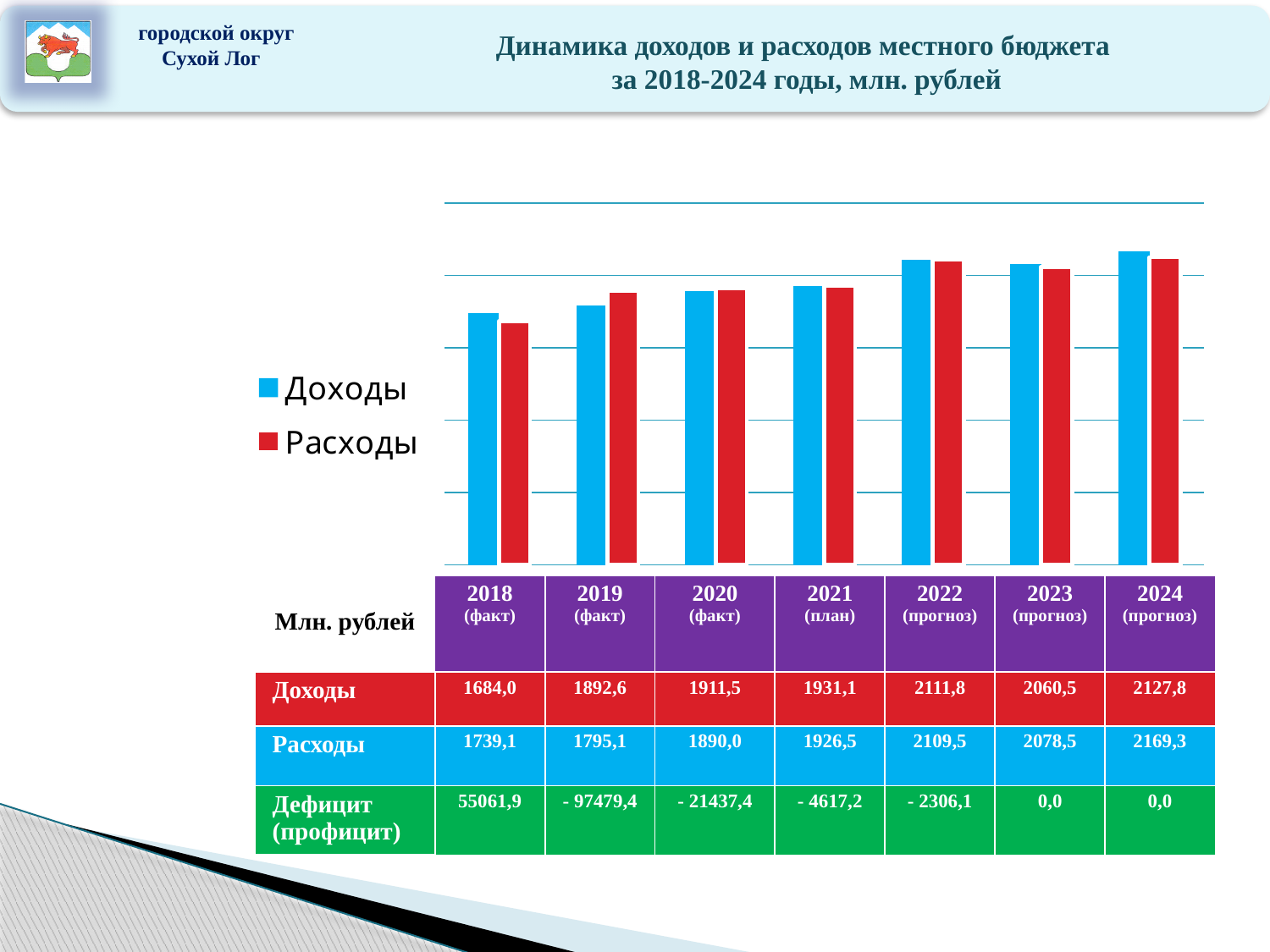
How many years are shown on the x axis of the chart? 7 Do the Доходы values rise or fall from 2018 to 2021? Rise In which year is Расходы the lowest? 2018 What is the value of Доходы for 2020 (факт)? 1911,5 What kind of chart is shown on the slide? Bar chart In which year is Доходы the highest? 2024 How many series does the legend list? 2 What is the value of Расходы for 2024 (прогноз)? 2169,3 What is the difference between Доходы and Расходы in 2022? 2,3 By how much do Расходы exceed Доходы in 2024? 41,5